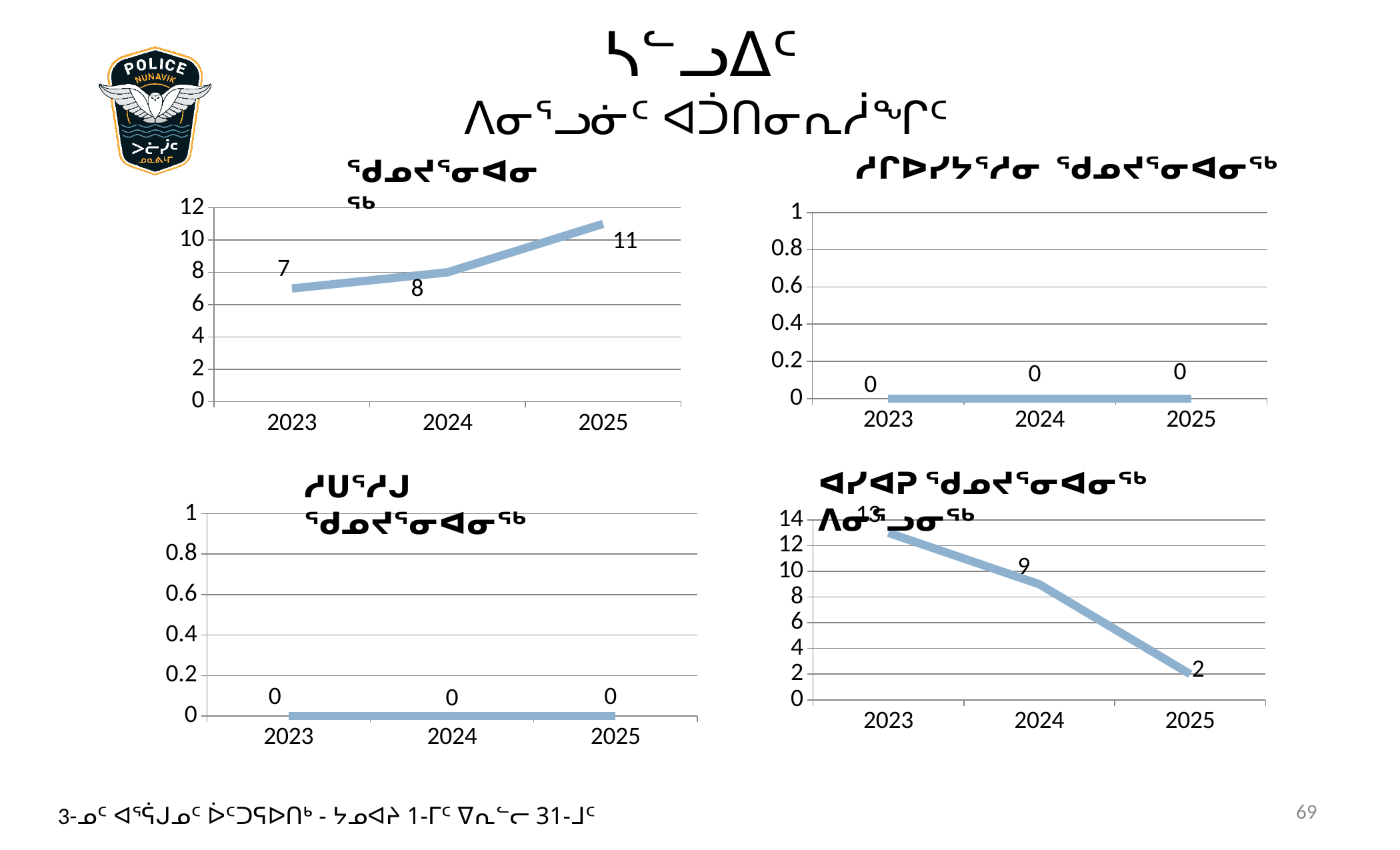
In the bottom-right chart, what is the value for 2024? 9 In the bottom-right chart, what is the value for 2025? 2 In the top-left chart, what is the difference between the 2025 and 2024 values? 3 In the top-right chart, what is the value for 2024? 0 How many years are plotted on the x axis of the top-left chart? 3 In the top-left chart, which year has the highest value? 2025 In the bottom-right chart, is the value for 2023 greater or less than 12? greater In the bottom-left chart, what is the value for 2025? 0 In the top-left chart, what is the value for 2023? 7 In the top-left chart, what is the value for 2025? 11 In the bottom-right chart, do the values rise or fall from 2023 to 2025? fall In the top-left chart, do the values rise or fall from 2023 to 2025? rise